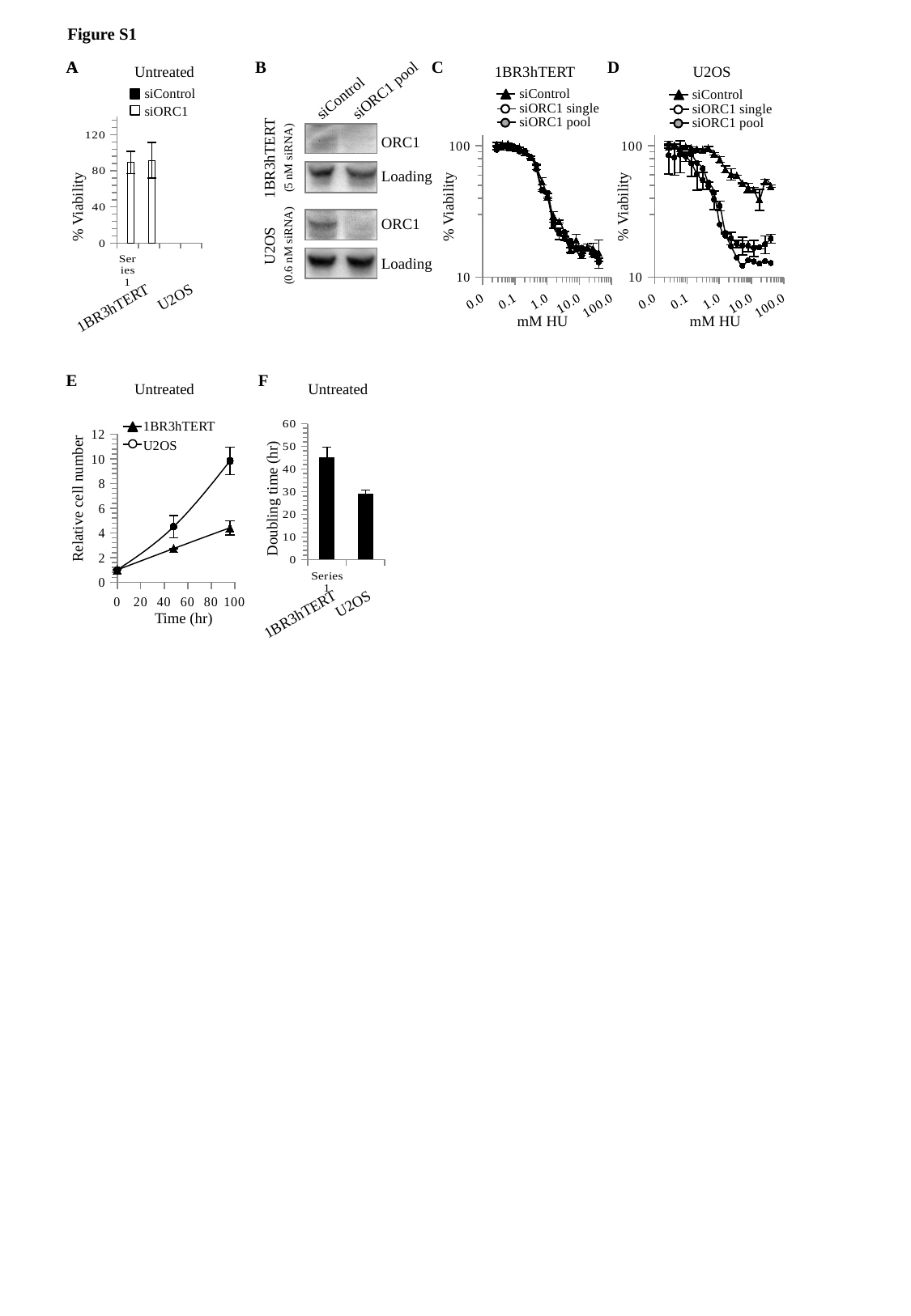
In chart E (Relative cell number), does the relative cell number rise or fall as time increases? rise What kind of chart is chart F (Doubling time)? bar chart In chart F (Doubling time), how many cell lines are plotted? 2 In chart F (Doubling time), which cell line has the higher doubling time? 1BR3hTERT In chart F (Doubling time), is the doubling time for 1BR3hTERT greater or less than 40? greater In chart C (1BR3hTERT), how many series does the legend list? 3 In chart F (Doubling time), is the doubling time for U2OS greater or less than 40? less In chart E (Relative cell number), how many series does the legend list? 2 In chart D (U2OS), which series remains highest in % Viability at high HU concentrations? siControl In chart C (1BR3hTERT), does % Viability rise or fall as mM HU increases? fall In chart E (Relative cell number), which cell line has the larger relative cell number at 100 hr? U2OS In chart E (Relative cell number), is the value for U2OS at 100 hr greater or less than 8? greater